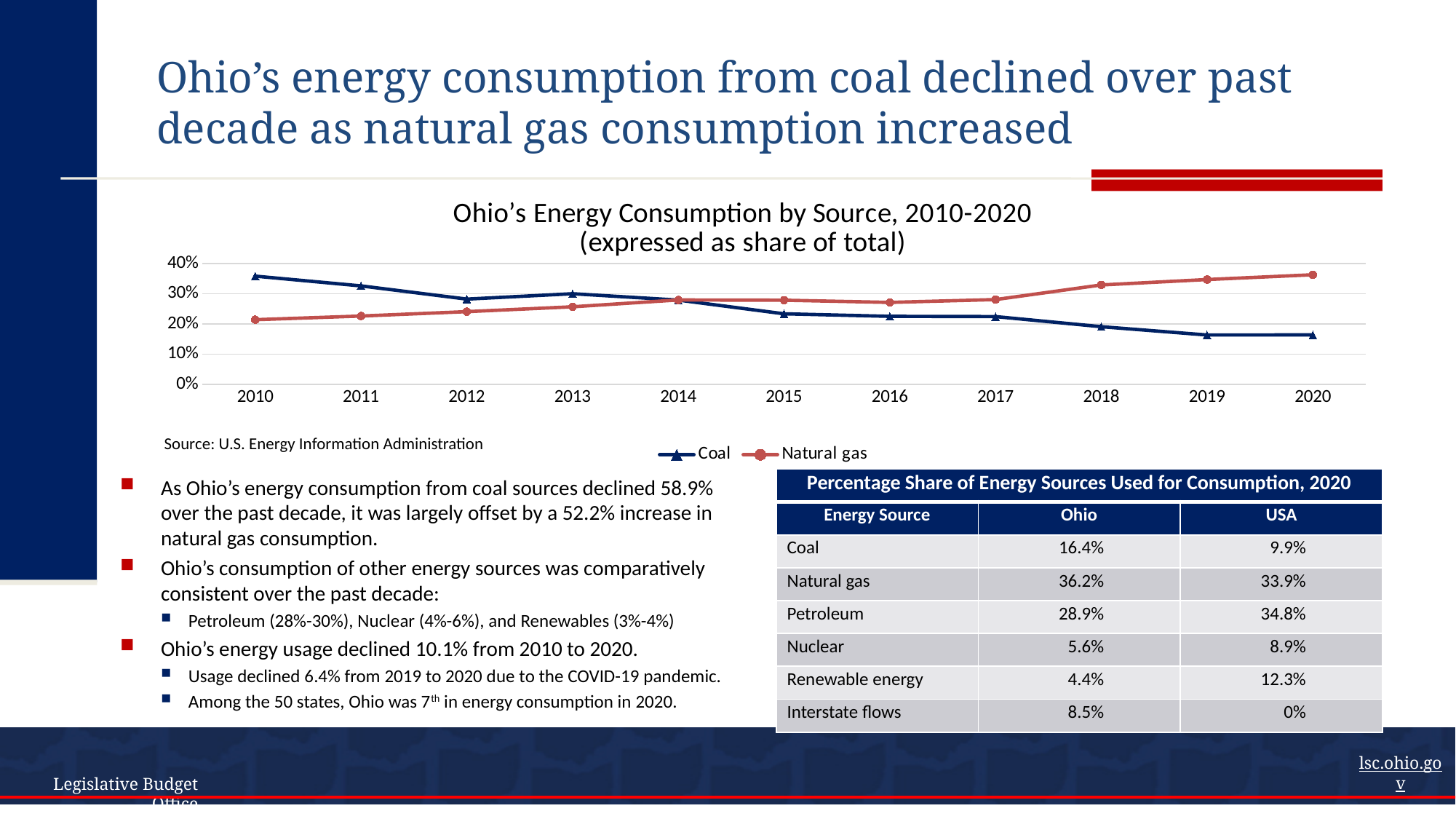
Is the Natural gas share in 2020 greater or less than 30%? greater How many years are plotted along the x axis of the chart? 11 Is the Coal share in 2020 greater or less than 20%? less In which year is the Coal share highest? 2010 What kind of chart is shown on the slide? line chart Does the Coal series rise or fall from 2010 to 2020? fall In which year is the Natural gas share lowest? 2010 How many series does the chart's legend list? 2 In which year is the Natural gas share highest? 2020 Is the Coal share in 2010 greater or less than 30%? greater Does the Natural gas series rise or fall from 2010 to 2020? rise In 2010, which series has the larger share, Coal or Natural gas? Coal